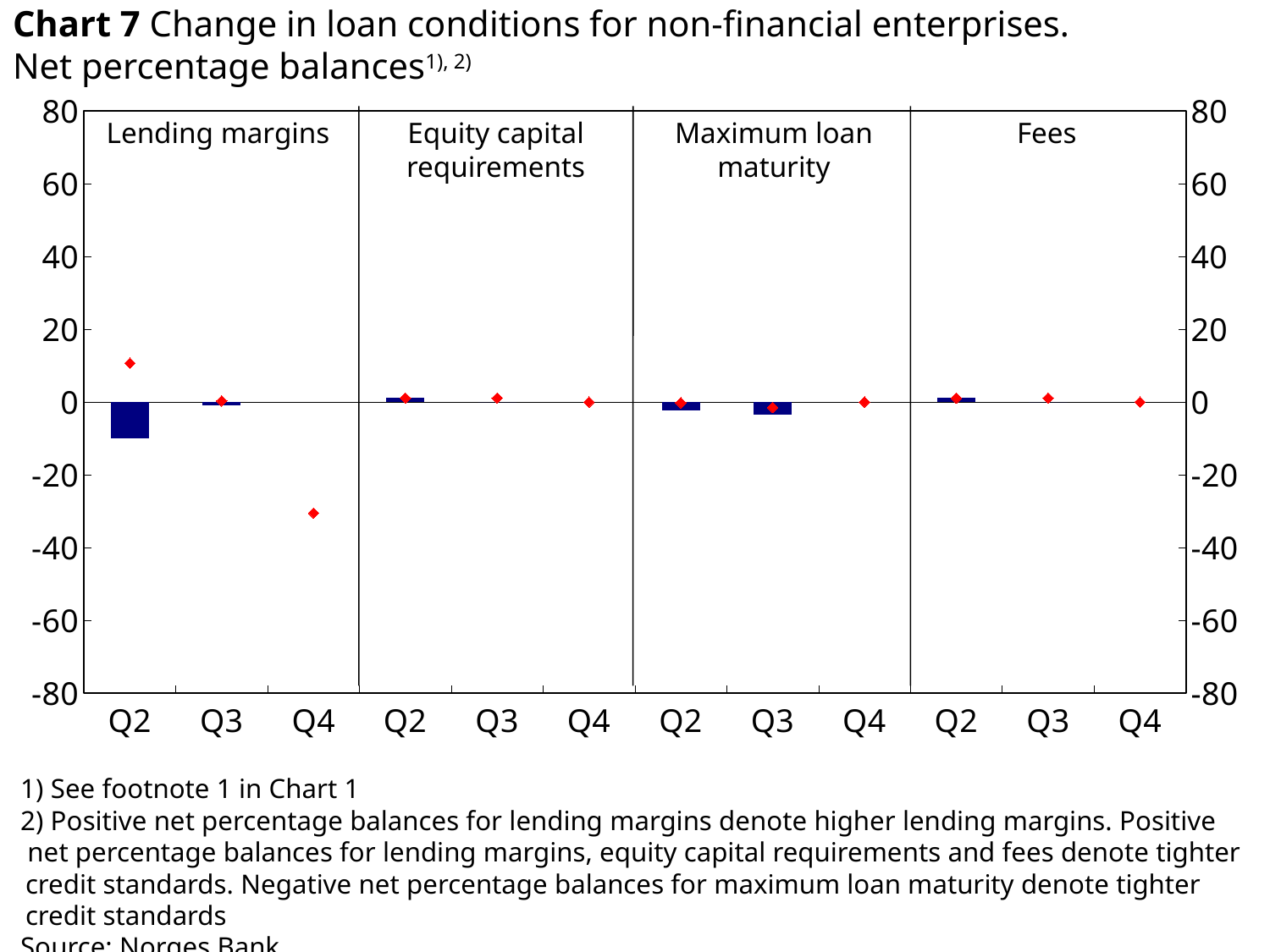
In the Lending margins panel, is the red diamond for Q4 greater or less than -20? less What kind of chart is shown on the slide? combination bar and line chart (bars with diamond markers) What is the maximum value shown on the vertical axis? 80 In the Lending margins panel, is the red diamond for Q2 greater or less than 0? greater In the Lending margins panel, is the red diamond for Q2 or for Q4 higher? Q2 How many quarters are shown on the x axis within each panel? 3 What is the title of the chart? Chart 7 Change in loan conditions for non-financial enterprises. Net percentage balances In the Lending margins panel, is the blue bar for Q2 greater or less than -20? greater In the Lending margins panel, which quarter has the lowest red diamond? Q4 In the Lending margins panel, which quarter has the highest red diamond? Q2 How many panels (loan condition categories) does the chart have? 4